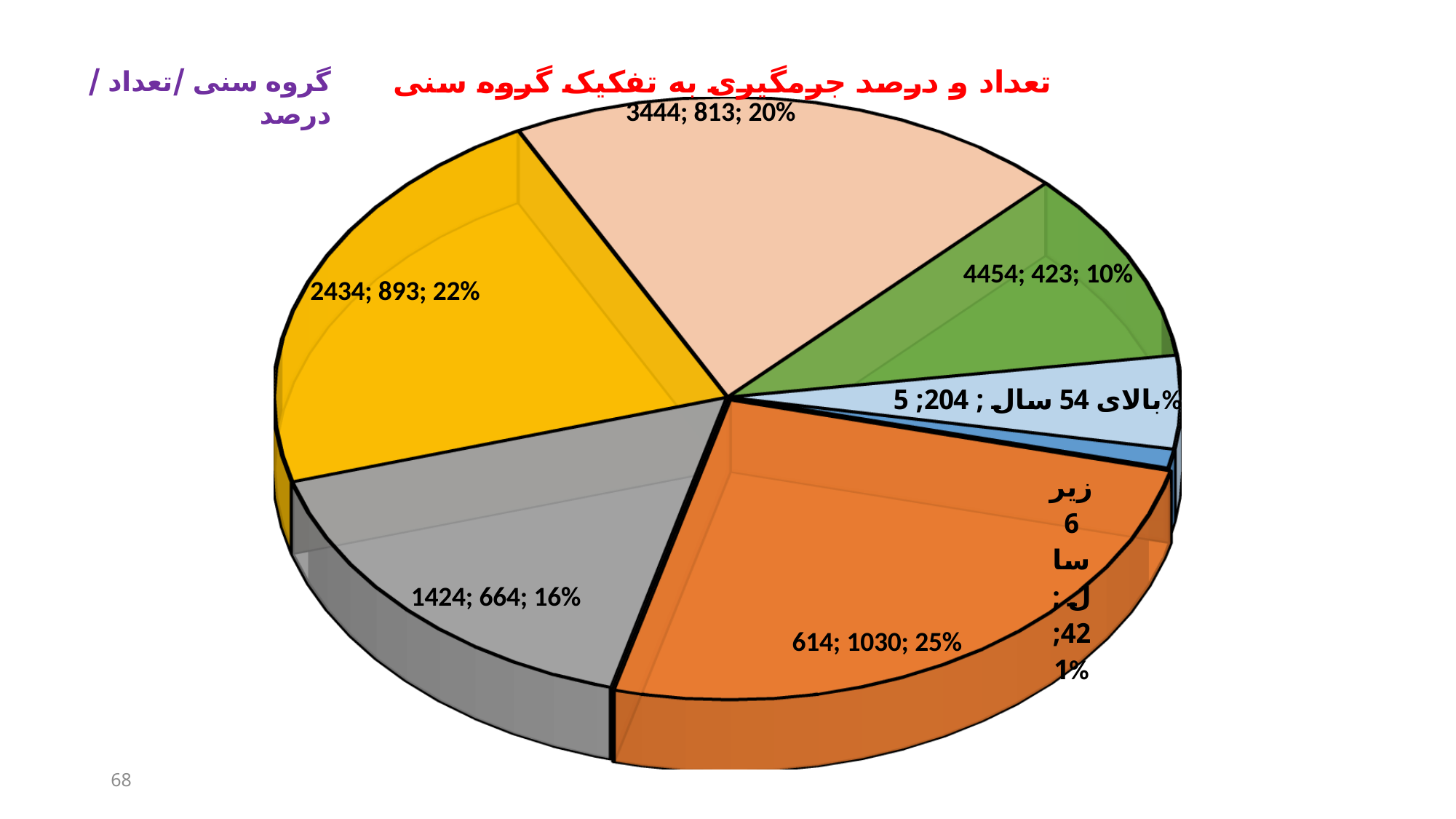
What is the count shown for the slice labelled 3444? 813 What is the title of the chart? تعداد و درصد جرمگیری به تفکیک گروه سنی How many slices does the pie chart have? 7 Which slice has the smallest count? زیر 6 سال What percentage is shown for the slice labelled 4454? 10% What is the difference between the counts of the slices labelled 614 and 1424? 366 What kind of chart is shown on the slide? pie chart What percentage is shown for the slice labelled 1424? 16% What is the count shown for the slice labelled بالای 54 سال? 204 What percentage is shown for the slice labelled زیر 6 سال? 1% Which slice has the largest count? 614 Which slice has a larger count, 2434 or 3444? 2434